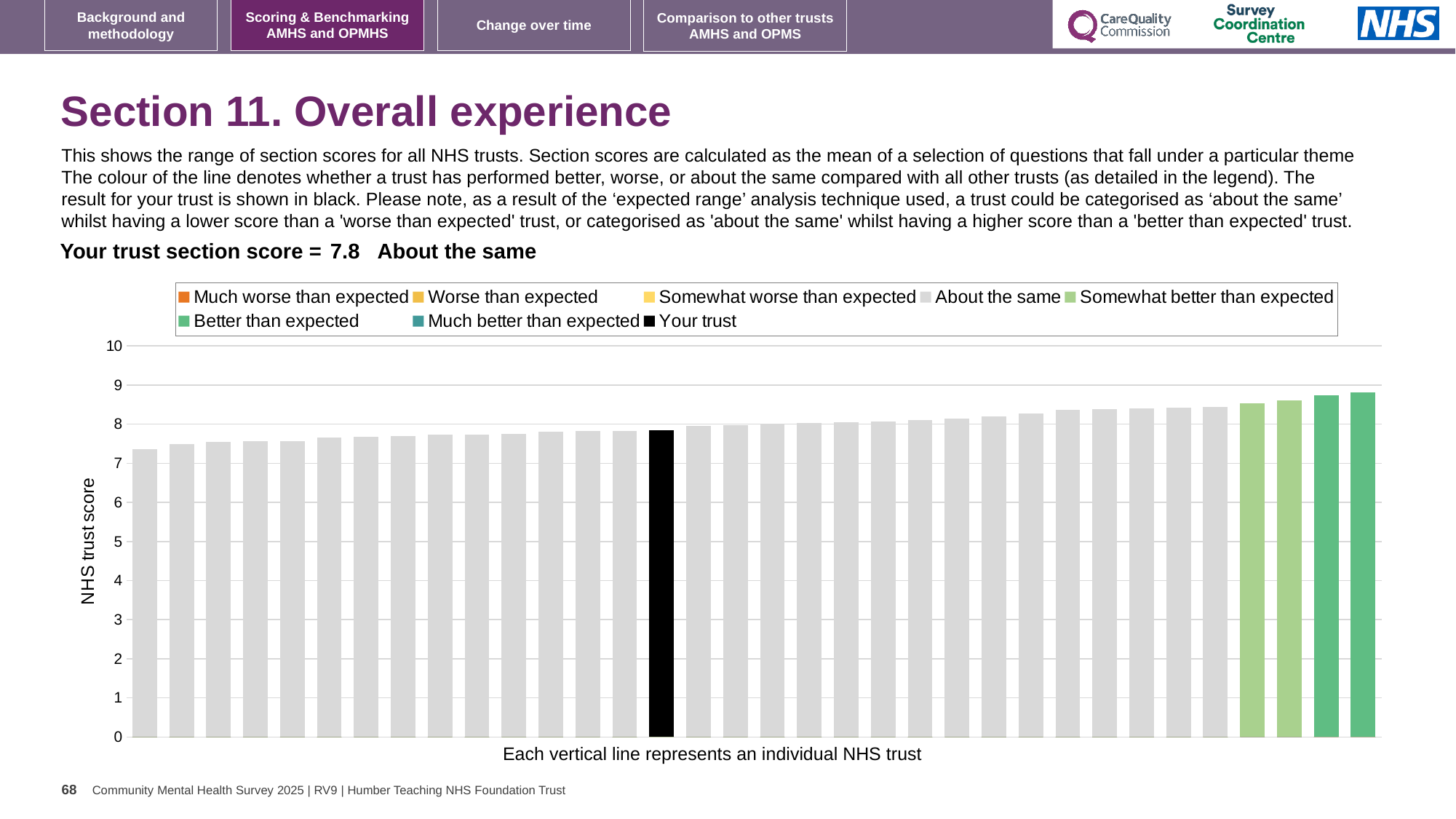
What colour is the bar representing your trust? black How many entries does the chart legend list? 8 What is the label on the y axis of the chart? NHS trust score How many bars are coloured as 'Better than expected'? 2 What is the section score for your trust shown on the slide? 7.8 Do the bar values rise or fall from left to right along the x axis? rise Is the value for the shortest bar on the left greater or less than 8? less Is the value for the black 'Your trust' bar greater or less than 7? greater How many bars are coloured as 'Somewhat better than expected'? 2 Which category is your trust's section score placed in? About the same What kind of chart is shown on the slide? bar chart Is the value for the tallest bar on the right greater or less than 8? greater